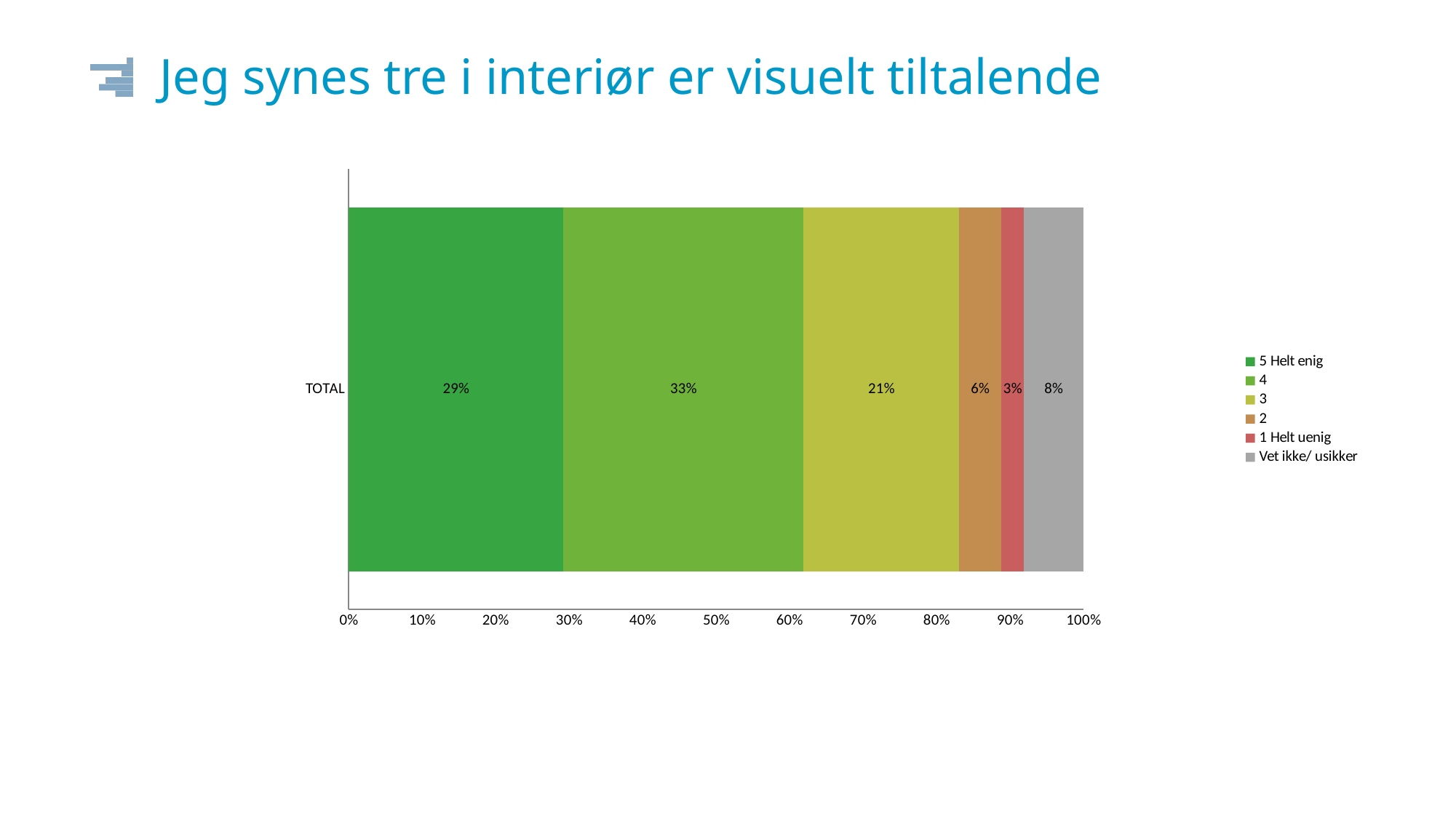
What percentage of respondents answered "5 Helt enig"? 29% What is the title of the slide? Jeg synes tre i interiør er visuelt tiltalende How many series does the legend list? 6 Which response category has the smallest share in the TOTAL bar? 1 Helt uenig What share of respondents answered "Vet ikke/ usikker"? 8% What is the difference between the shares for "4" and "5 Helt enig"? 4 percentage points What kind of chart is shown on the slide? Stacked bar chart What is the value for the "4" series in the TOTAL bar? 33% Which is larger, the share for "3" or the share for "2"? 3 What is the value for "1 Helt uenig"? 3% Which response category has the largest share in the TOTAL bar? 4 What is the combined share of "5 Helt enig" and "4"? 62%